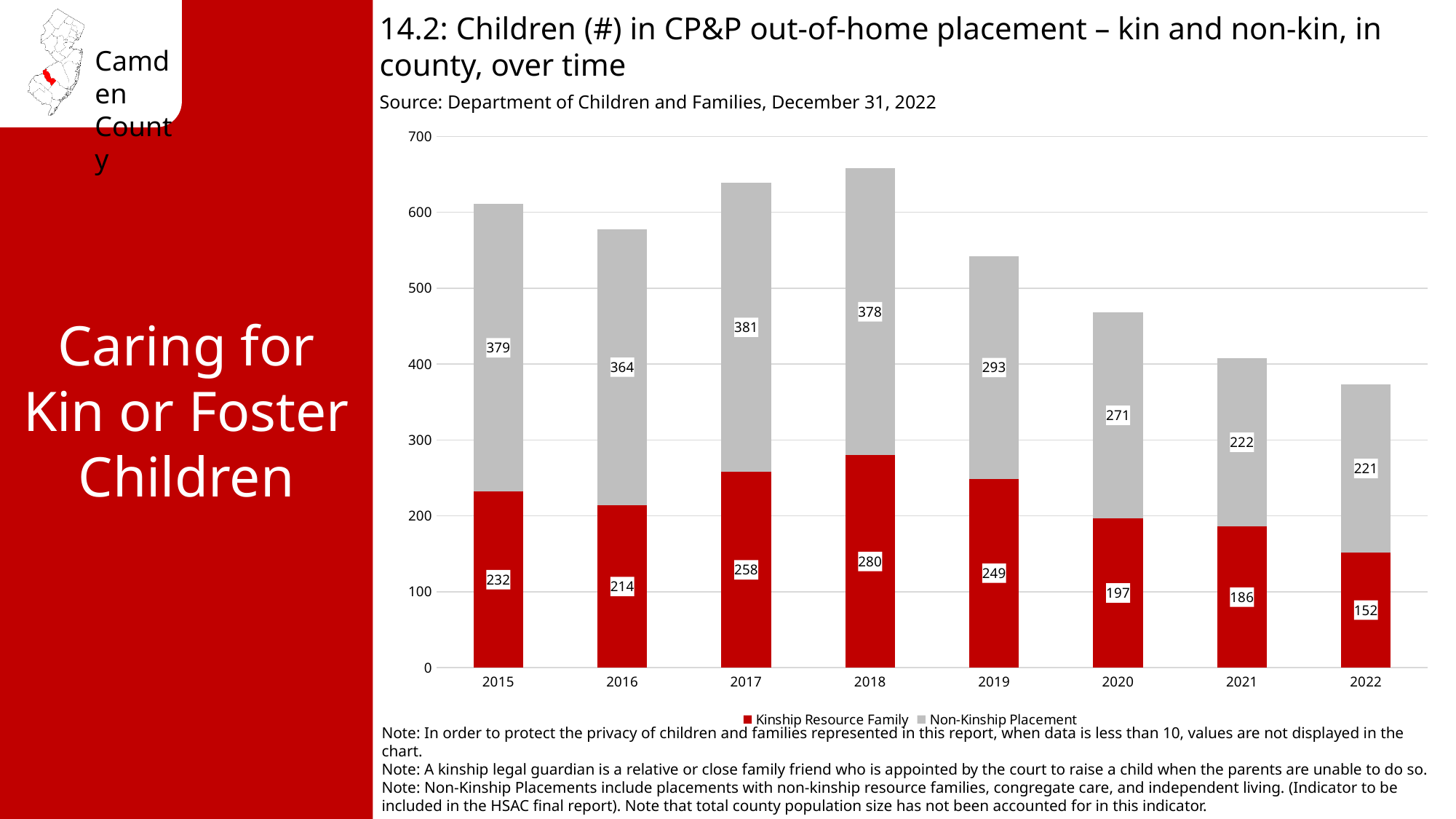
What kind of chart is shown on the slide? Stacked bar chart What is the Kinship Resource Family value for 2018? 280 Which year has the highest Kinship Resource Family value? 2018 Does the Kinship Resource Family value rise or fall from 2018 to 2022? Fall What is the total of the stacked bar for 2022? 373 How many series does the legend list? 2 What is the Non-Kinship Placement value for 2020? 271 How many years are shown on the x axis? 8 Which year has the lowest Non-Kinship Placement value? 2022 What is the difference between the Non-Kinship Placement and Kinship Resource Family values in 2015? 147 Which colour represents Kinship Resource Family in the chart? Red Which is larger in 2021: the Kinship Resource Family value or the Non-Kinship Placement value? Non-Kinship Placement